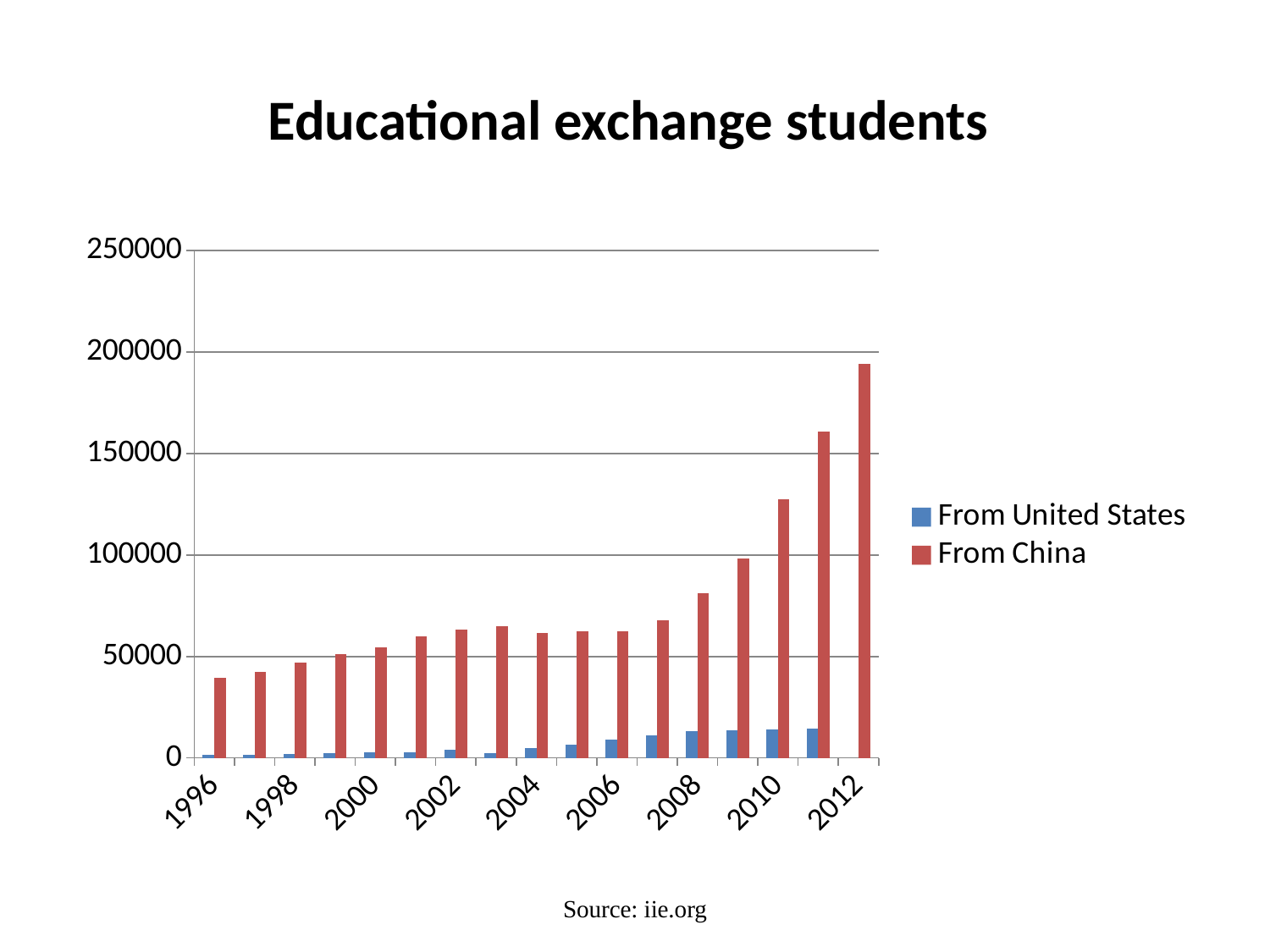
Is the value for From China in 2010 greater or less than 100000? greater Which is larger: From China in 2012 or From China in 2010? From China in 2012 Is the value for From China in 2012 greater or less than 150000? greater How many years (categories) are plotted on the x axis? 17 What kind of chart is shown on the slide? bar chart Which year has the lowest value for From China? 1996 Do the values for From China generally rise or fall from 1996 to 2012? rise Is the value for From United States in 2010 greater or less than 50000? less Which year has the highest value for From China? 2012 What is the title of the chart? Educational exchange students How many series does the legend list? 2